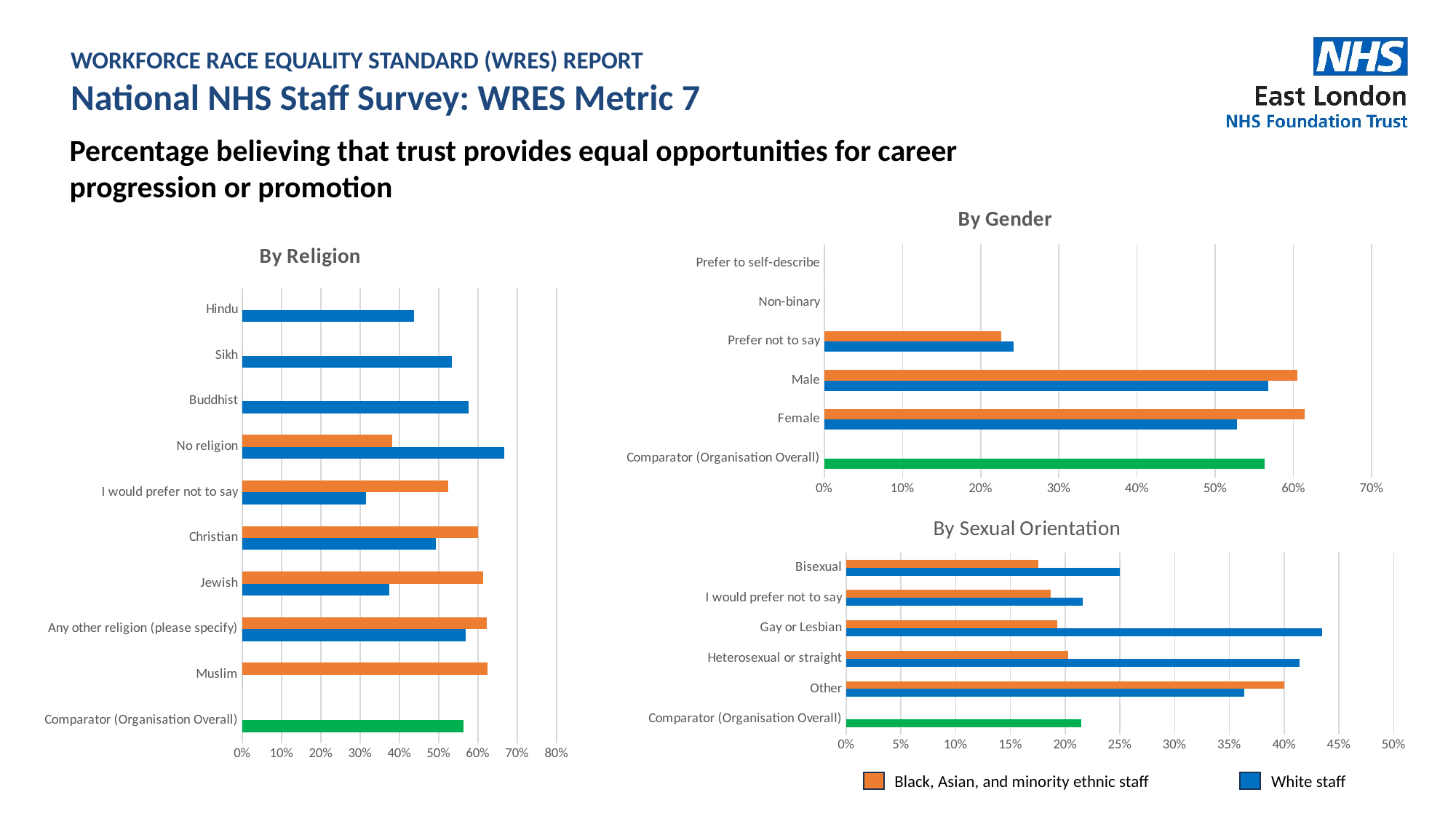
In the 'By Gender' chart, is the value for Black, Asian, and minority ethnic staff in the 'Prefer not to say' category greater or less than 30%? less What kind of chart is the 'By Religion' chart? bar chart In the 'By Sexual Orientation' chart, which is larger for the 'Other' category: the value for Black, Asian, and minority ethnic staff or the value for White staff? Black, Asian, and minority ethnic staff In the 'By Religion' chart, is the value for Black, Asian, and minority ethnic staff in the 'No religion' category greater or less than 50%? less In the 'By Religion' chart, which category has the lowest value for White staff? I would prefer not to say In the 'By Religion' chart, which category has the highest value for White staff? No religion In the 'By Religion' chart, is the value for White staff in the 'No religion' category greater or less than 60%? greater In the 'By Religion' chart, which is larger for the 'Jewish' category: the value for Black, Asian, and minority ethnic staff or the value for White staff? Black, Asian, and minority ethnic staff How many series does the legend at the bottom of the slide list? 2 How many categories are listed on the y axis of the 'By Sexual Orientation' chart? 6